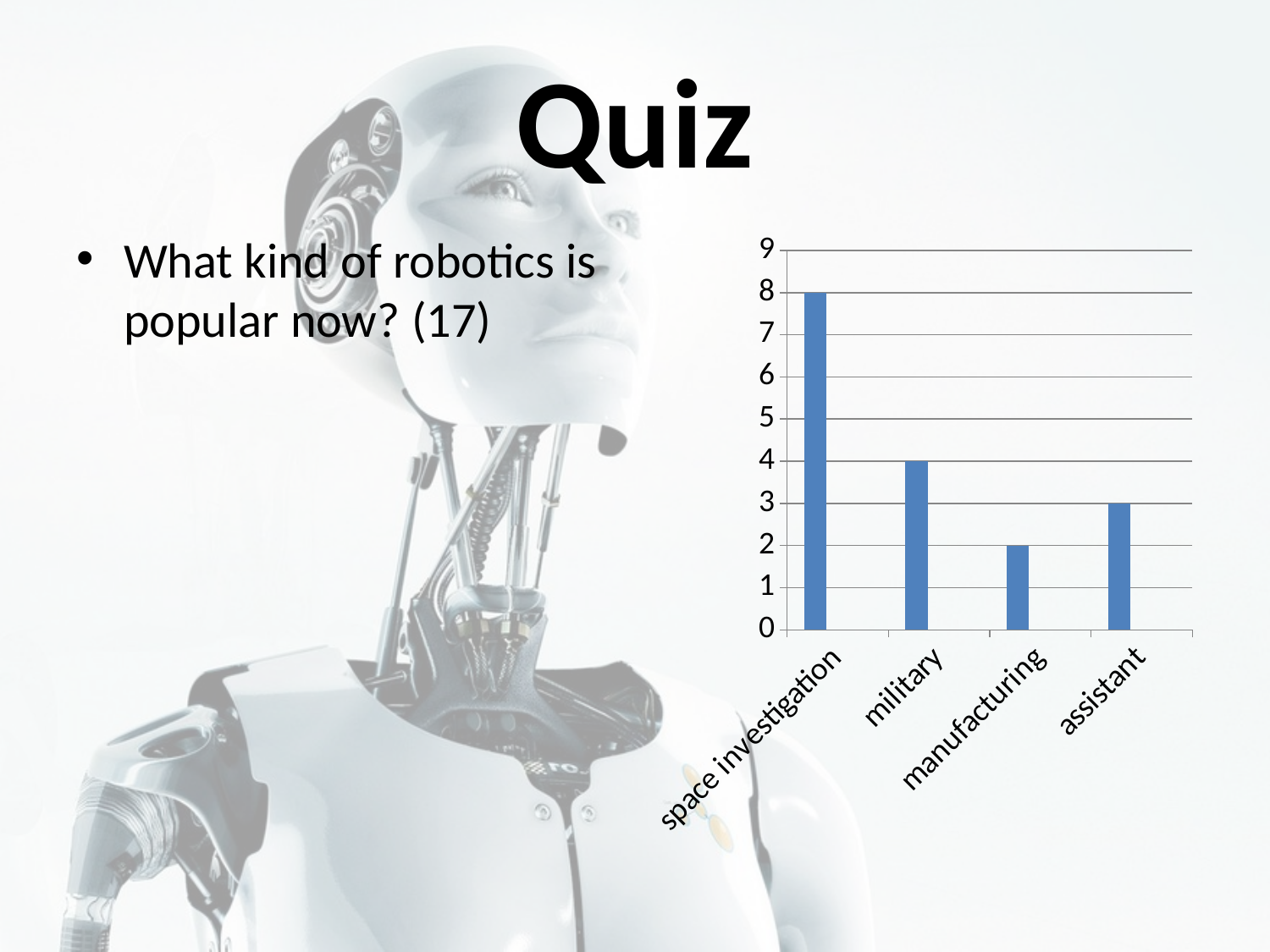
How many categories are shown on the x axis of the chart? 4 What is the highest value shown on the y axis of the chart? 9 Is the value for military greater or less than 5? less What is the difference between the values for space investigation and military? 4 Which is larger, the value for assistant or the value for manufacturing? assistant What kind of chart is shown on the slide? bar chart What is the value for assistant? 3 What is the value for space investigation? 8 Which category has the highest value? space investigation What is the value for military? 4 What is the value for manufacturing? 2 Which category has the lowest value? manufacturing